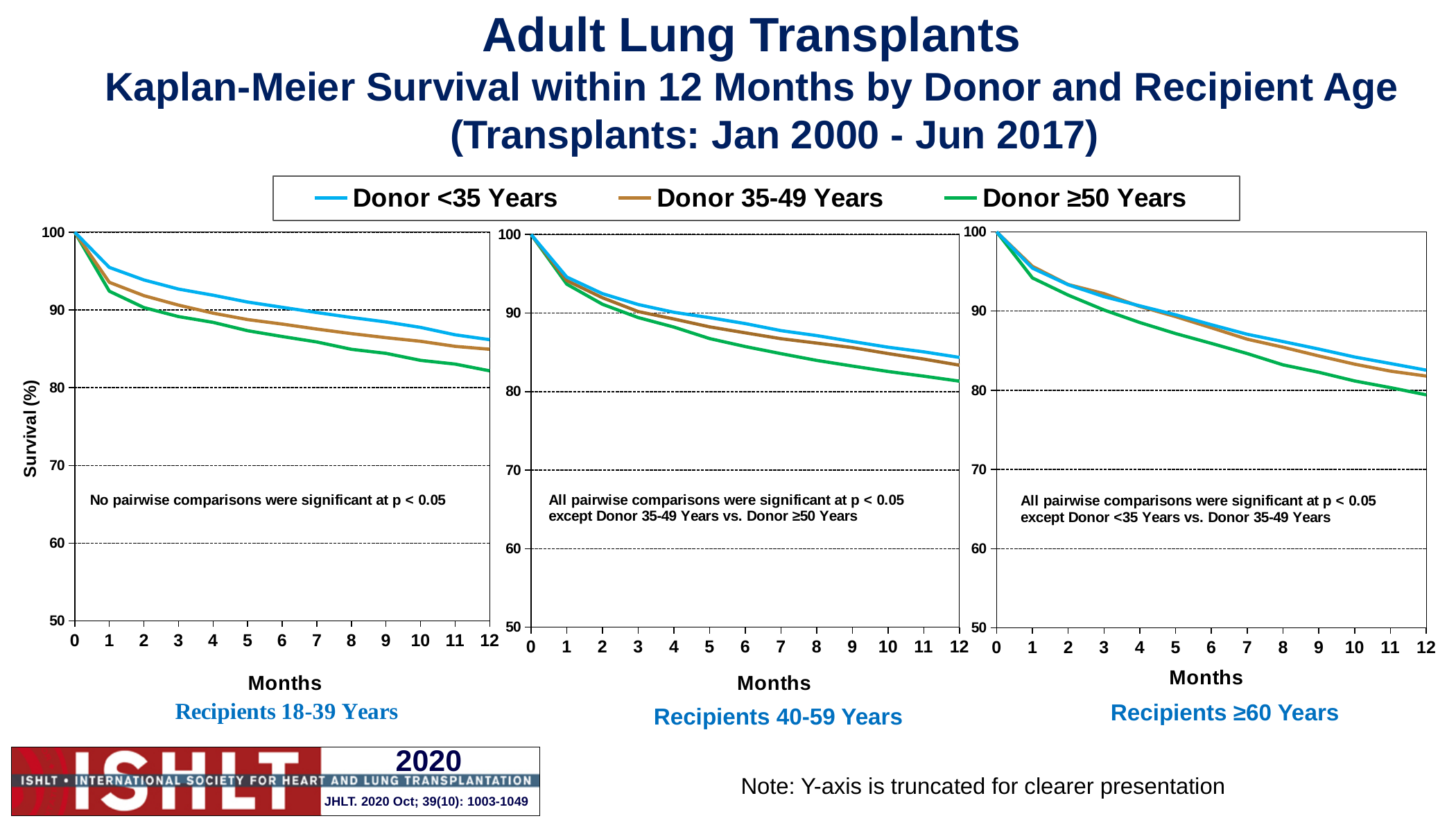
What are the three series named in the legend? Donor <35 Years, Donor 35-49 Years, Donor ≥50 Years In the Recipients ≥60 Years chart, is the value for Donor ≥50 Years at month 12 greater or less than 70? greater In the Recipients 40-59 Years chart, is the value for Donor <35 Years at month 12 greater or less than 80? greater How many survival charts are shown on the slide? 3 In the Recipients 18-39 Years chart, what is the survival value for Donor <35 Years at month 0? 100 In the Recipients ≥60 Years chart, which series has the lowest survival at month 12? Donor ≥50 Years In the Recipients 18-39 Years chart, is the value for Donor ≥50 Years at month 12 greater or less than 90? less What kind of chart is used in the Recipients 18-39 Years panel? line chart How many series does the shared legend list? 3 In the Recipients 40-59 Years chart, do the survival curves rise or fall as months increase? fall In the Recipients 18-39 Years chart, which is higher at month 12: Donor <35 Years or Donor ≥50 Years? Donor <35 Years What does the annotation inside the Recipients 18-39 Years chart say about pairwise comparisons? No pairwise comparisons were significant at p < 0.05